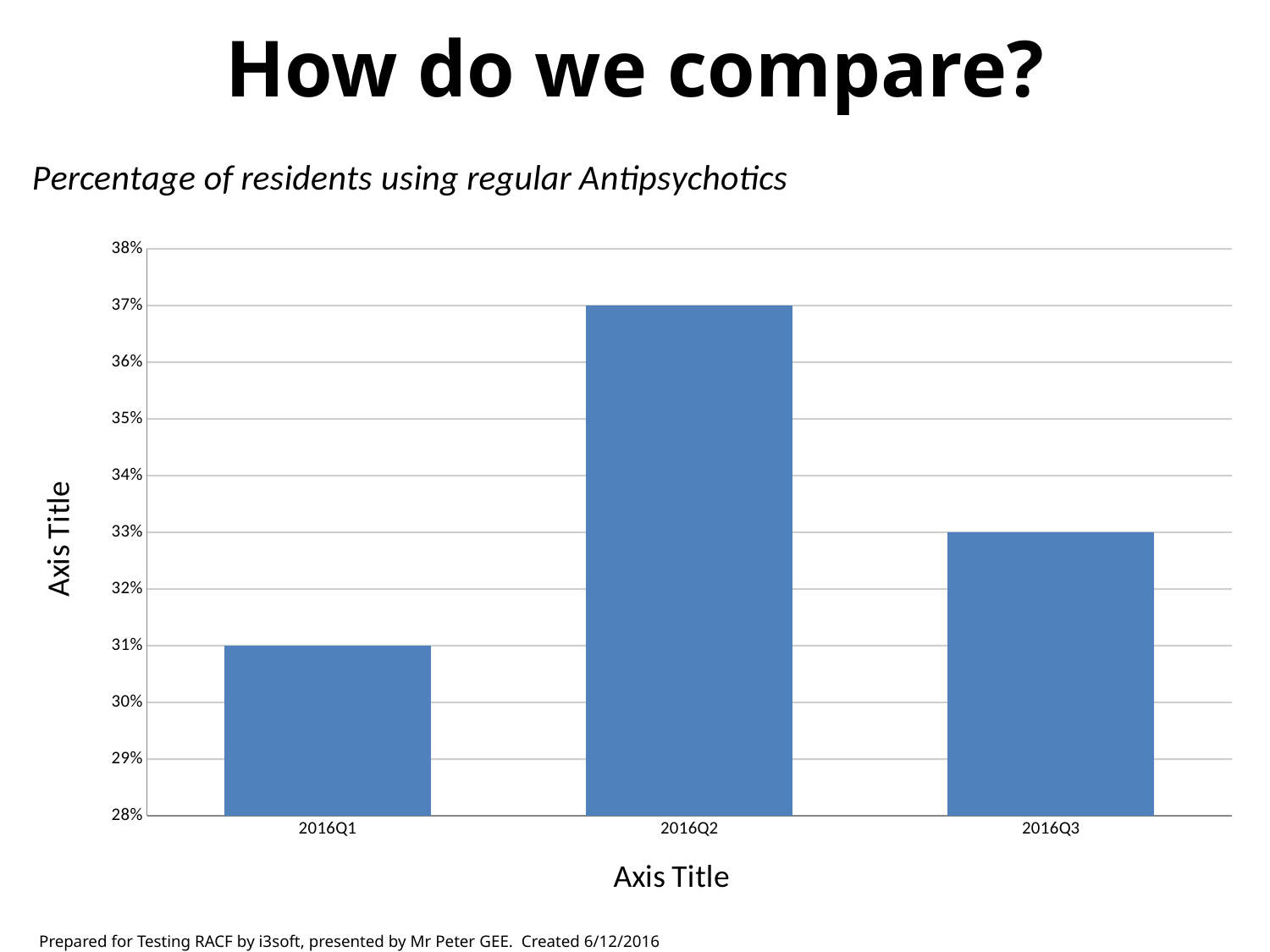
What is the lowest value shown on the vertical axis? 28% What is the difference between the values for 2016Q2 and 2016Q3? 4% What is the value for 2016Q3? 33% Which quarter has the lowest percentage of residents using regular antipsychotics? 2016Q1 What is the value for 2016Q2? 37% Which is larger, the value for 2016Q3 or the value for 2016Q1? 2016Q3 What kind of chart is shown on the slide? bar chart What is the value for 2016Q1? 31% Which quarter has the highest percentage of residents using regular antipsychotics? 2016Q2 Is the value for 2016Q2 greater or less than 35%? greater What is the difference between the values for 2016Q2 and 2016Q1? 6% How many quarters are shown on the x axis? 3